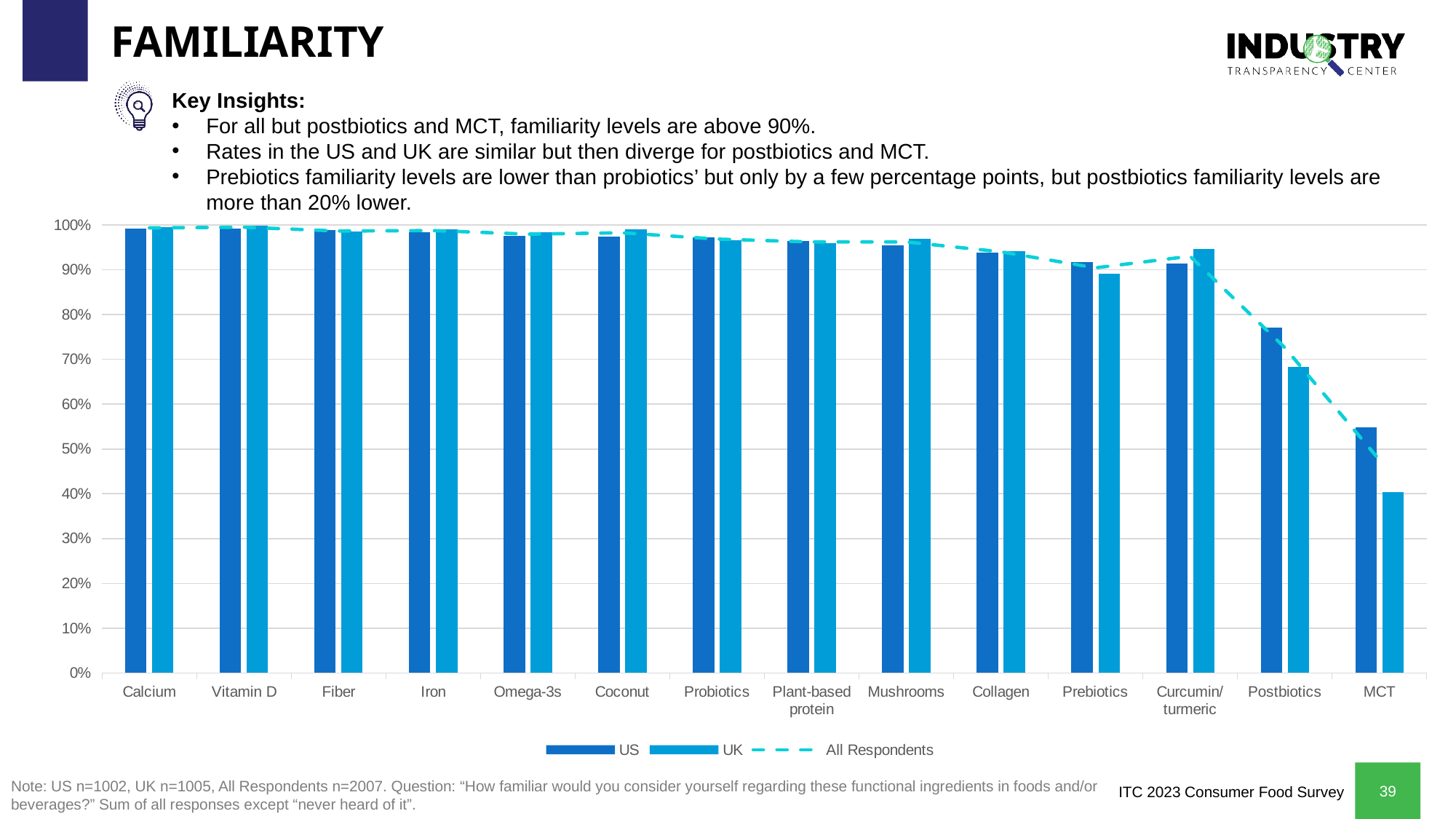
Do the familiarity values generally rise or fall moving from left to right along the x axis? Fall How many series does the chart's legend list? 3 Which ingredient has the lowest familiarity level for the US series? MCT Is the US value for MCT greater or less than 50%? greater Which ingredient has the lowest familiarity level for the UK series? MCT For Curcumin/turmeric, which is larger, the US value or the UK value? UK For MCT, which is larger, the US value or the UK value? US Is the US value for Collagen greater or less than 90%? greater How many ingredient categories are shown on the x axis of the chart? 14 Is the US value for Postbiotics greater or less than 70%? greater What kind of chart is shown on the slide? Combination bar and line chart